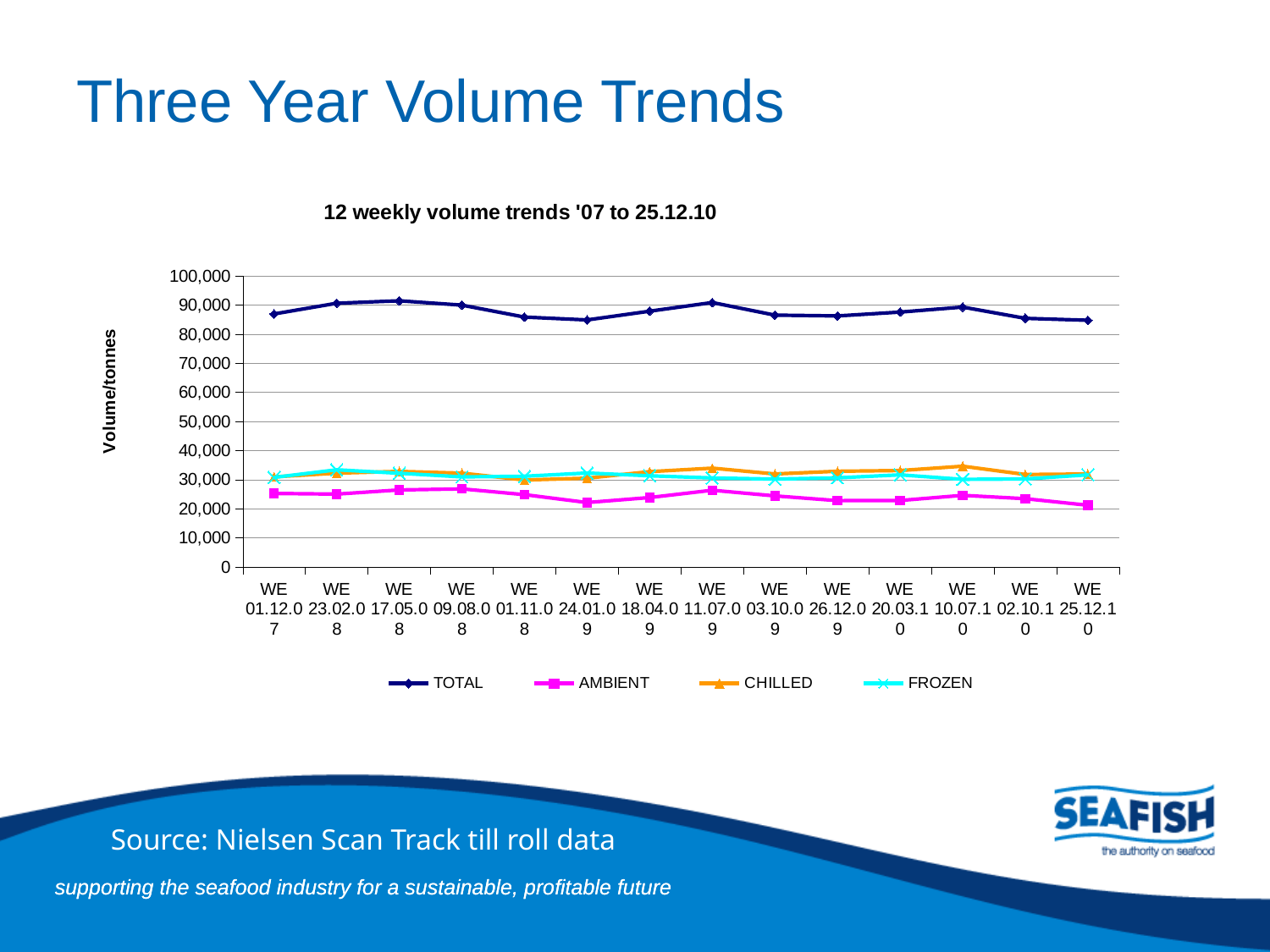
Is the TOTAL value for WE 01.12.07 greater or less than 80,000? greater At WE 25.12.10, which is larger, the AMBIENT value or the CHILLED value? CHILLED Is the AMBIENT value for WE 11.07.09 greater or less than 30,000? less Is the CHILLED value for WE 10.07.10 greater or less than 30,000? greater How many series does the legend list? 4 How many weekly data points are plotted along the x axis? 14 What is the label on the y axis? Volume/tonnes What kind of chart is shown on the slide? line chart What is the title of the chart? 12 weekly volume trends '07 to 25.12.10 Which series has the lowest values across the whole chart? AMBIENT Which series has the highest values across the whole chart? TOTAL